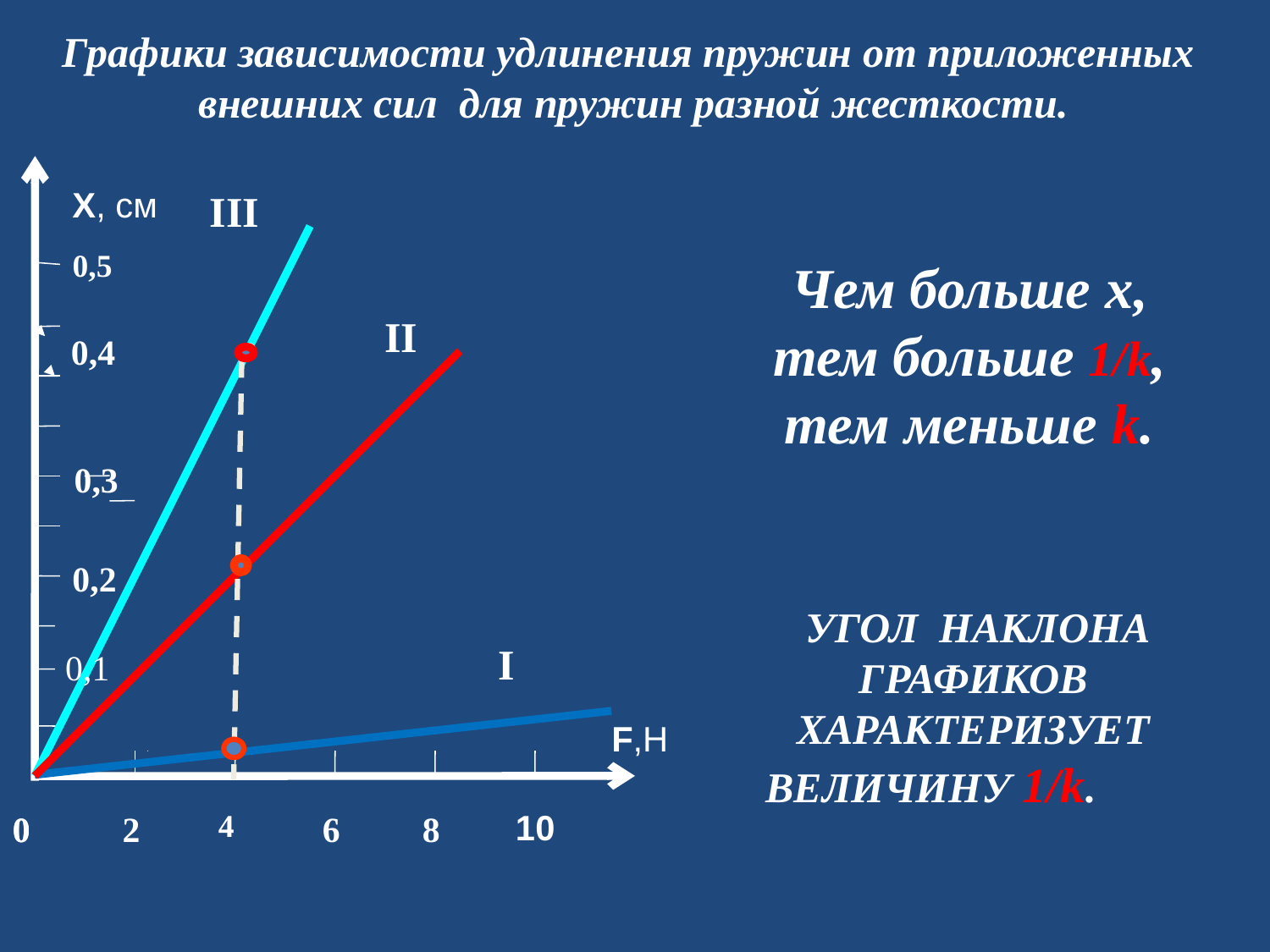
Do the lines rise or fall as F increases along the x axis? rise What is the largest value labelled on the horizontal F axis? 10 What quantity and unit are labelled on the vertical axis? X, см Is the extension x for line II at F = 4 Н greater or less than 0,3? less How many lines (graphs) are plotted on the chart? 3 What is the extension x for line III at F = 4 Н? 0,4 см Which line has the largest extension x at F = 4 Н? III What kind of chart is shown on the slide? line chart Is the extension x for line I at F = 4 Н greater or less than 0,1? less Which line has the smallest extension x at F = 4 Н? I At F = 4 Н, which line has the larger extension, line II or line I? II